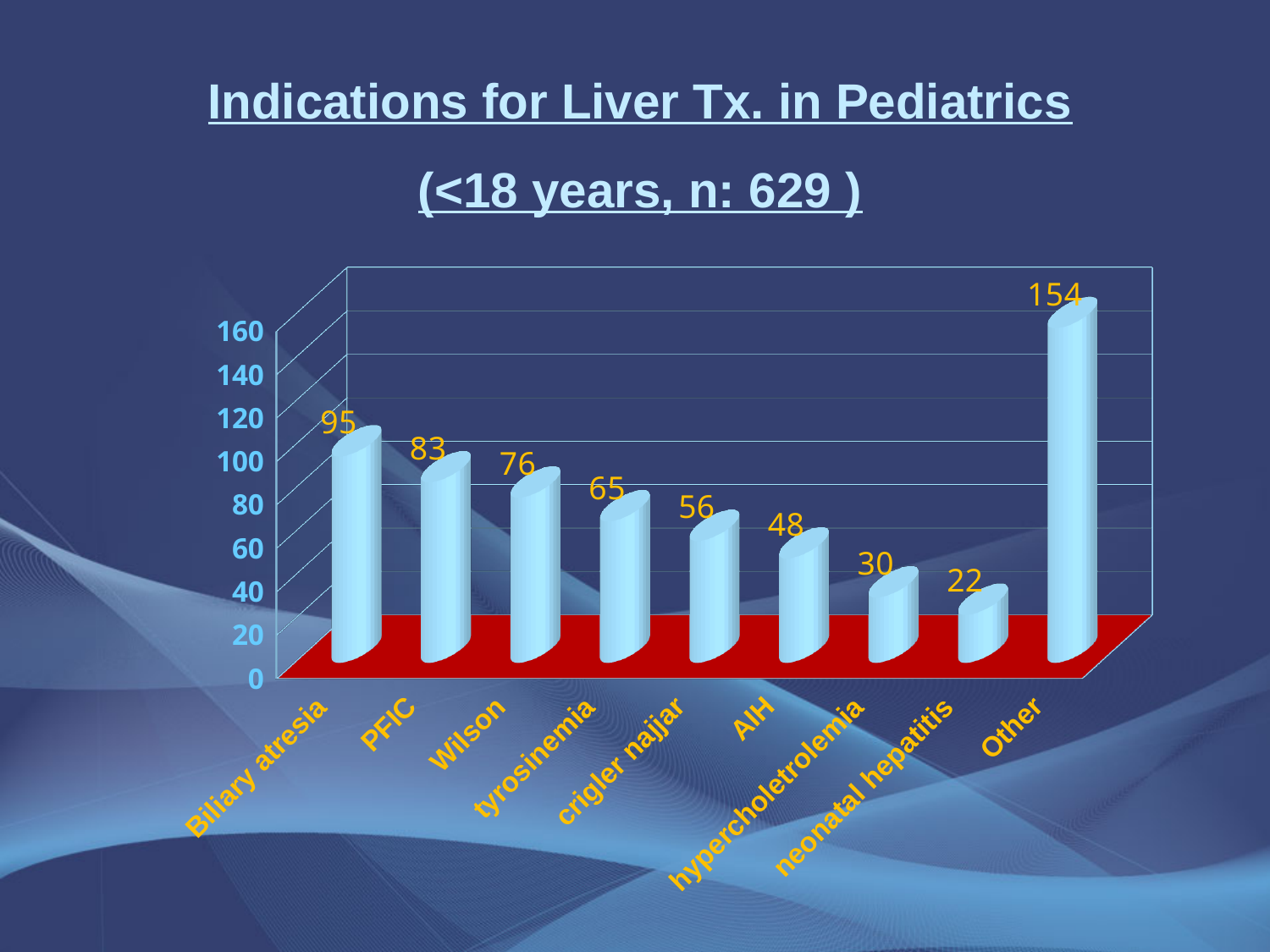
How many categories are shown on the x axis? 9 Which category has the lowest value? neonatal hepatitis What is the value for Biliary atresia? 95 Which category has the highest value? Other Which is larger, the value for tyrosinemia or the value for crigler najjar? tyrosinemia What is the title of the chart on the slide? Indications for Liver Tx. in Pediatrics (<18 years, n: 629 ) What is the value for Wilson? 76 Excluding the Other category, do the values rise or fall from left to right along the x axis? fall What is the value for neonatal hepatitis? 22 What is the difference between the values for Other and AIH? 106 What kind of chart is shown on the slide? bar chart What is the difference between the values for Biliary atresia and PFIC? 12